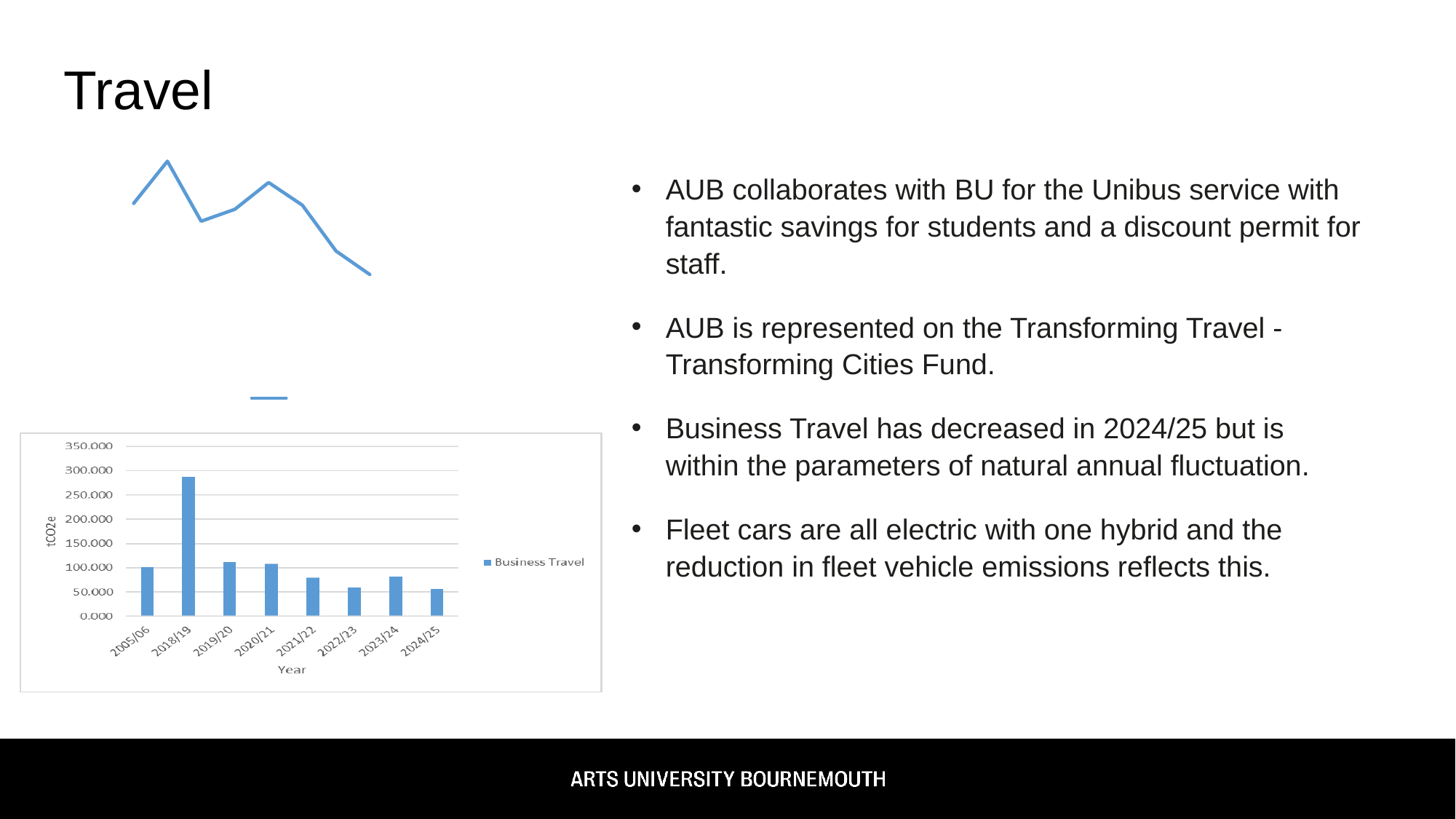
In the bar chart at the bottom of the slide, is the Business Travel value for 2021/22 greater or less than 100.000? less How many years are shown on the x axis of the bar chart at the bottom of the slide? 8 In the bar chart at the bottom of the slide, is the Business Travel value for 2022/23 greater or less than 100.000? less In the bar chart at the bottom of the slide, is the Business Travel value for 2005/06 greater or less than 50.000? greater In the bar chart at the bottom of the slide, which is larger: the Business Travel value for 2023/24 or for 2022/23? 2023/24 In the bar chart at the bottom of the slide, which is larger: the Business Travel value for 2018/19 or for 2005/06? 2018/19 What kind of chart is the chart at the bottom of the slide? Bar chart In the bar chart at the bottom of the slide, which year has the highest Business Travel value? 2018/19 How many series does the legend of the bar chart at the bottom of the slide list? 1 What is the y-axis label of the bar chart at the bottom of the slide? tCO2e